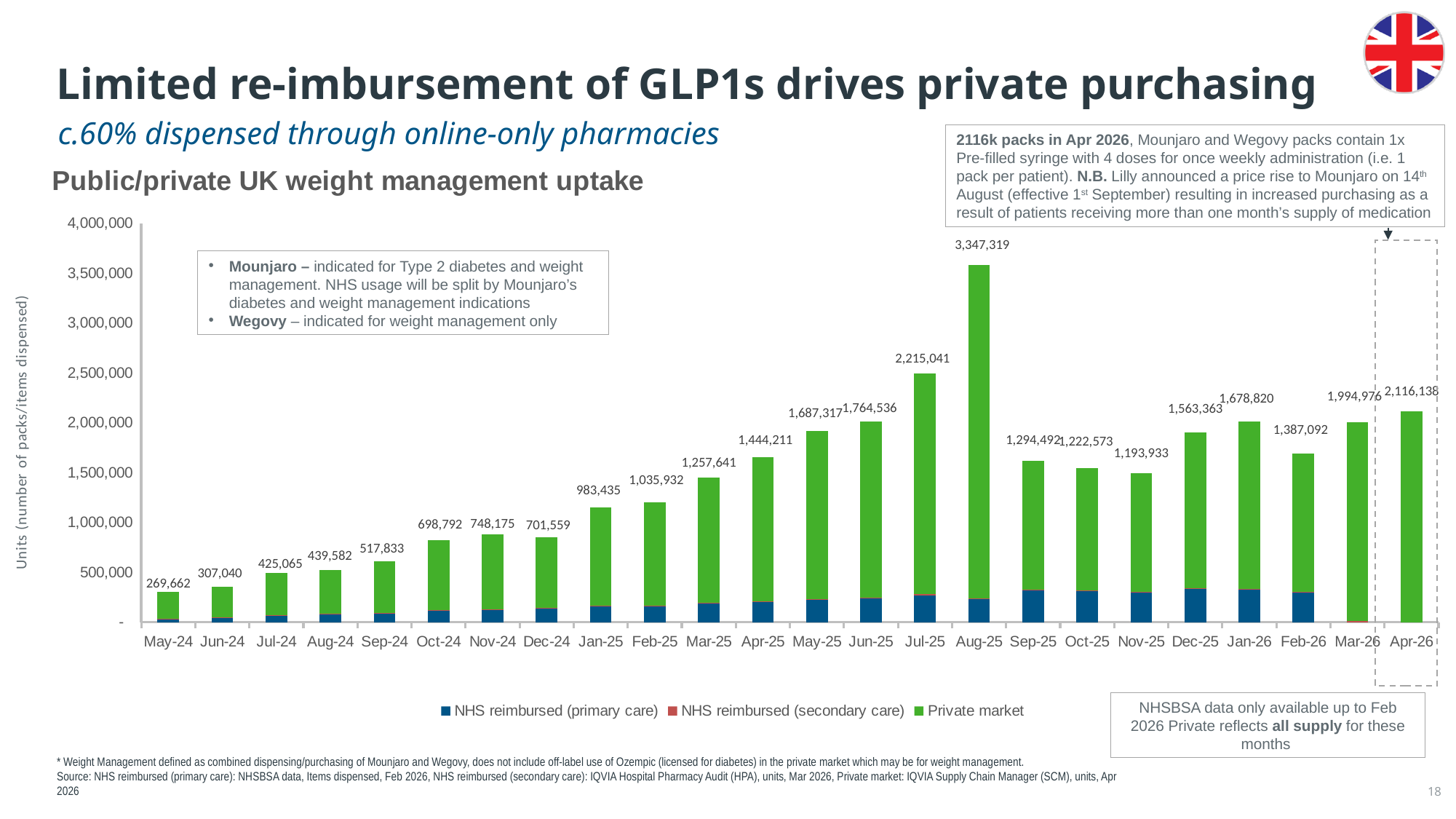
Which month has the highest labelled value? Aug-25 Which month has the lowest labelled value? May-24 What value is labelled for the May-24 bar? 269,662 How many months are shown along the x axis? 24 Which series is shown in green in the legend? Private market Is the total bar height for Jul-25 greater or less than 2,000,000? greater What value is labelled for the Aug-25 bar? 3,347,319 What is the difference between the labelled values for Aug-25 and Jul-25? 1,132,278 How many series does the legend list? 3 What type of chart is shown on the slide? bar chart Which has the larger labelled value, Nov-24 or Dec-24? Nov-24 What value is labelled for the Apr-26 bar? 2,116,138